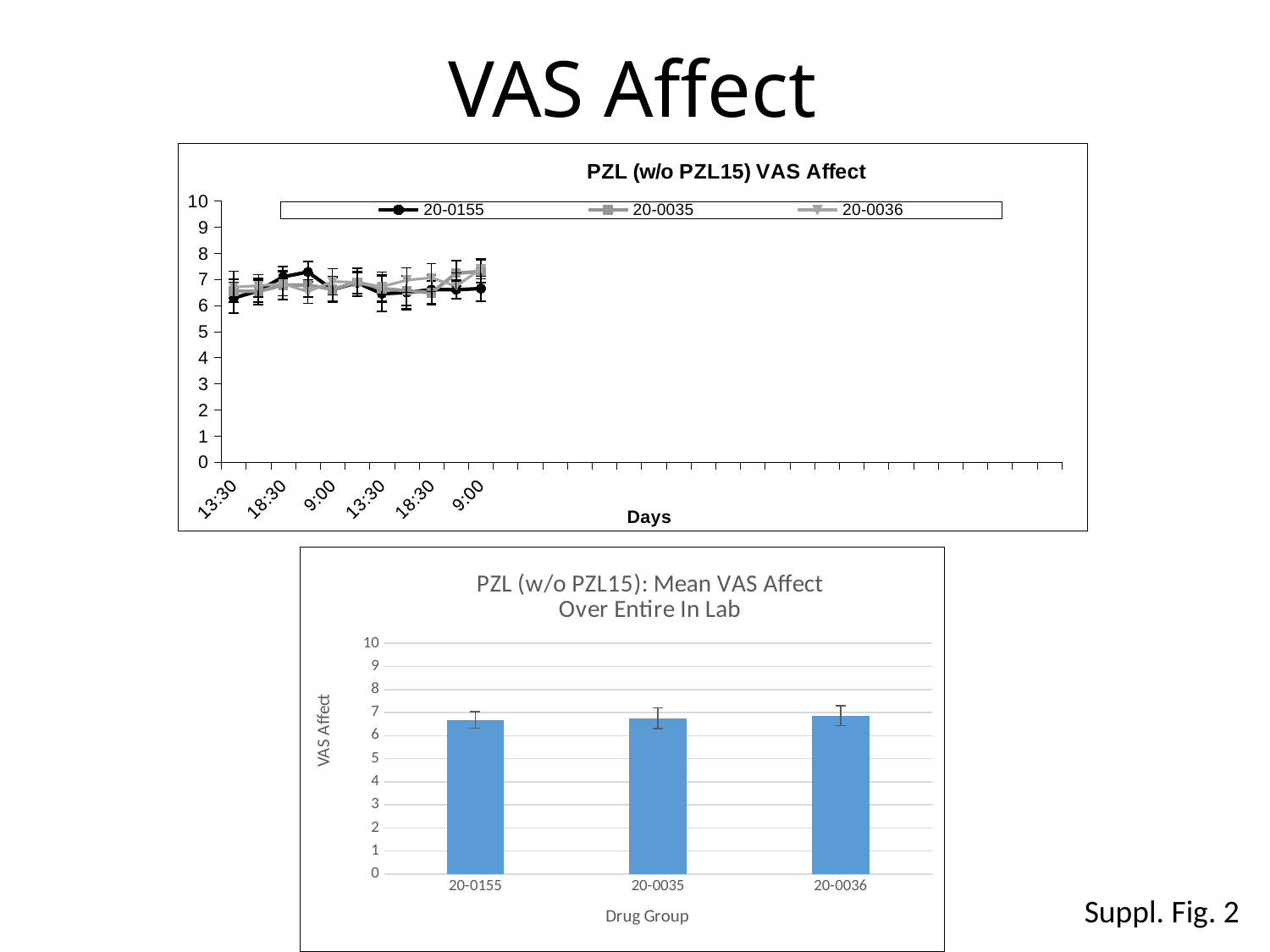
How many drug groups are shown on the x axis of the bottom bar chart? 3 In the bottom bar chart, is the value for 20-0035 greater or less than 8? less How many series does the legend of the top chart "PZL (w/o PZL15) VAS Affect" list? 3 What kind of chart is the bottom chart titled "PZL (w/o PZL15): Mean VAS Affect Over Entire In Lab"? bar chart In the top line chart, is the value for 20-0035 at the last plotted time point greater or less than 9? less In the bottom bar chart, is the value for 20-0155 greater or less than 7? less What kind of chart is the top chart titled "PZL (w/o PZL15) VAS Affect"? line chart What is the x-axis title of the bottom bar chart? Drug Group What is the x-axis title of the top line chart? Days